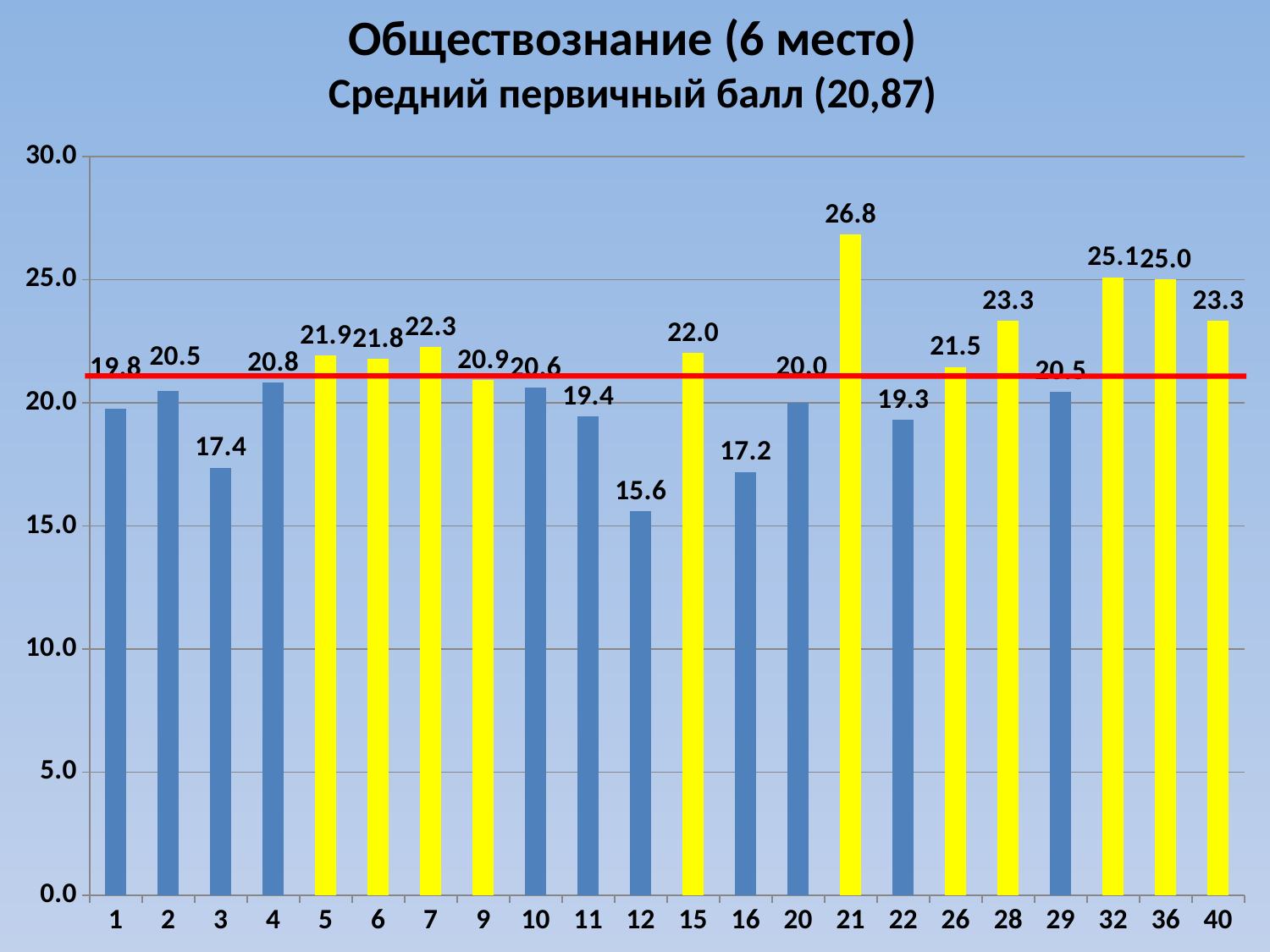
Is the value for category 32 greater or less than 25.0? greater What is the difference between the values for category 21 and category 12? 11.2 What is the value for category 21? 26.8 What type of chart is shown on the slide? bar chart How many categories are shown on the x axis? 22 What is the value for category 7? 22.3 What is the value for category 12? 15.6 Which category has the highest value? 21 Which category has the lowest value? 12 What is the value for category 36? 25.0 Which is larger, the value for category 3 or the value for category 16? category 3 What average score is given in the chart's subtitle? 20,87